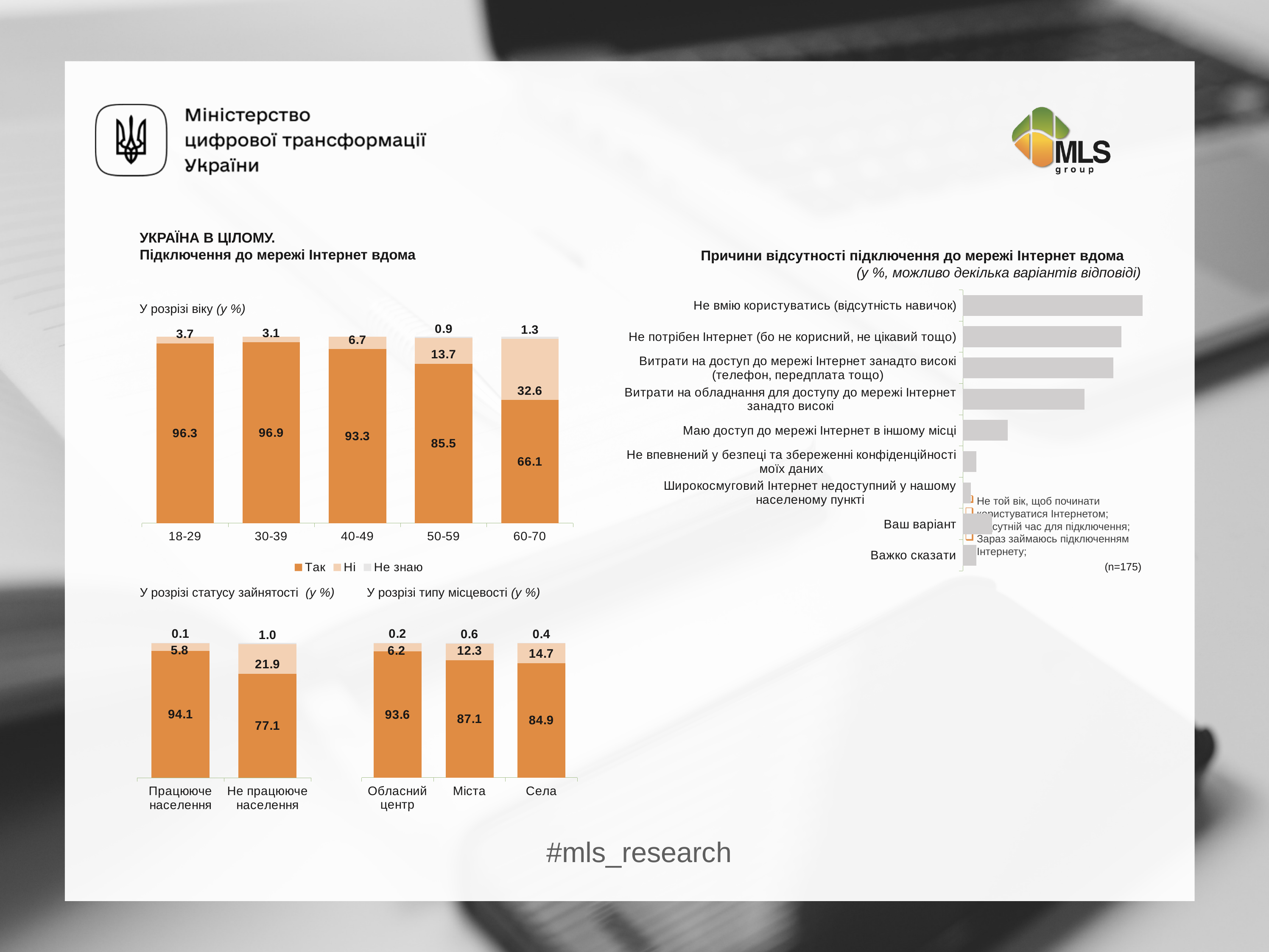
In the 'У розрізі віку' chart, what is the difference between the 'Ні' values for 60-70 and 50-59? 18.9 In the 'У розрізі типу місцевості' chart, what is the total of the stacked bar for 'Міста'? 100.0 In the 'У розрізі віку' chart, how many age groups are shown on the x axis? 5 In the 'У розрізі віку' chart, do the 'Так' values generally rise or fall from the 18-29 group to the 60-70 group? fall In the 'У розрізі віку' chart, what is the 'Так' value for the 60-70 age group? 66.1 How many series does the legend of the 'У розрізі віку' chart list? 3 In the 'Причини відсутності підключення до мережі Інтернет вдома' chart, which reason has the longest bar? Не вмію користуватись (відсутність навичок) In the 'У розрізі віку' chart, what is the 'Ні' value for the 50-59 age group? 13.7 In the 'У розрізі типу місцевості' chart, which locality type has the lowest 'Так' value? Села In the 'У розрізі віку' chart, which age group has the highest 'Так' value? 30-39 In the 'У розрізі статусу зайнятості' chart, what is the 'Ні' value for 'Не працююче населення'? 21.9 In the 'У розрізі віку' chart, which age group has the lowest 'Так' value? 60-70